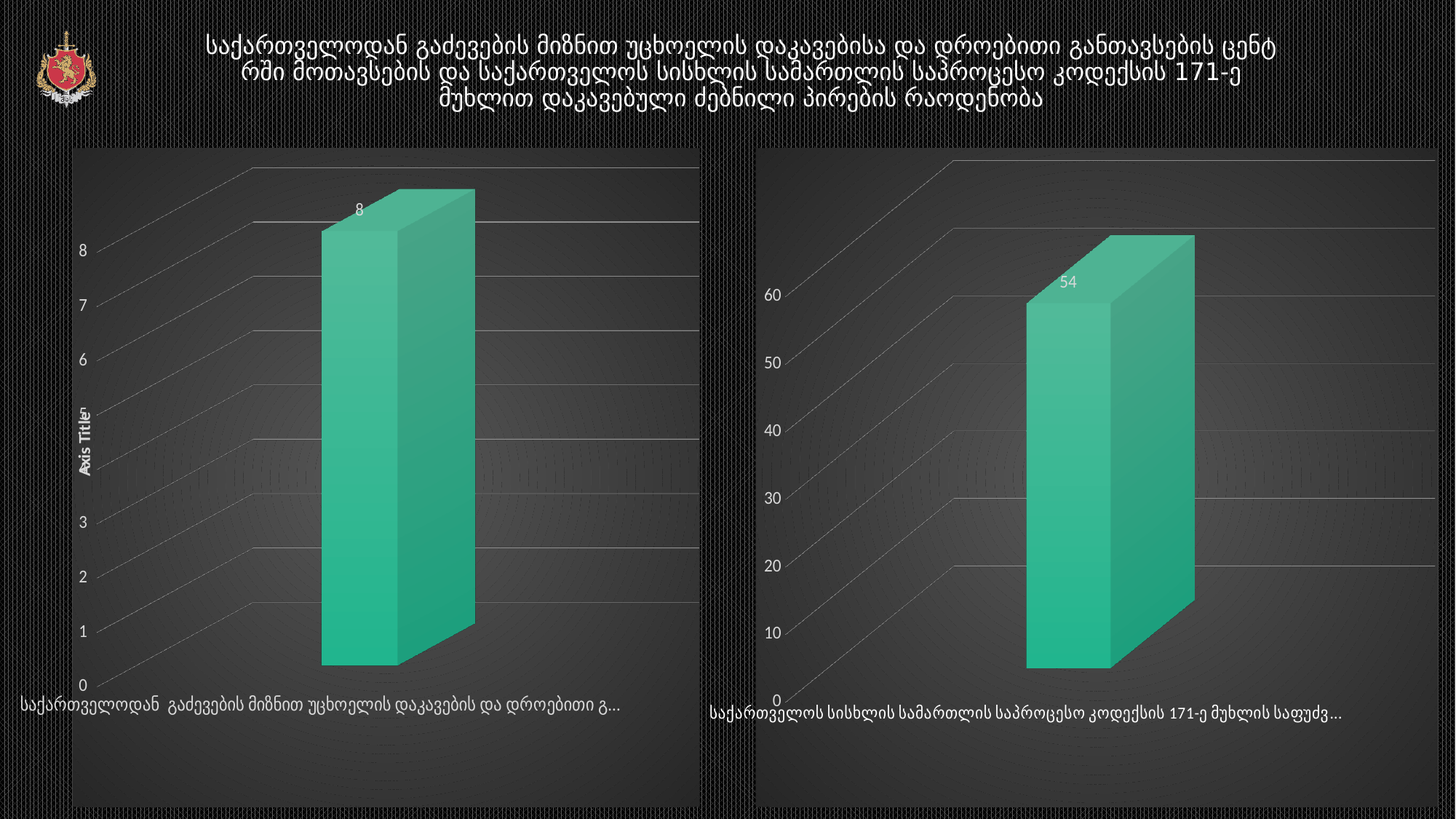
In the chart on the right, is the bar value greater or less than 50? greater What kind of chart is the chart on the right? bar chart In the chart on the left, what text is shown as the vertical axis title? Axis Title In the chart on the right, what value is shown on the bar? 54 In the chart on the left, what value is shown on the bar? 8 In the chart on the left, is the bar value greater or less than 5? greater In the chart on the left, what is the highest tick value shown on the vertical axis? 8 How many bars does the chart on the left show? 1 What kind of chart is the chart on the left? bar chart Which chart shows the larger bar value, the chart on the left or the chart on the right? the chart on the right What is the difference between the bar value in the chart on the right and the bar value in the chart on the left? 46 How many bars does the chart on the right show? 1